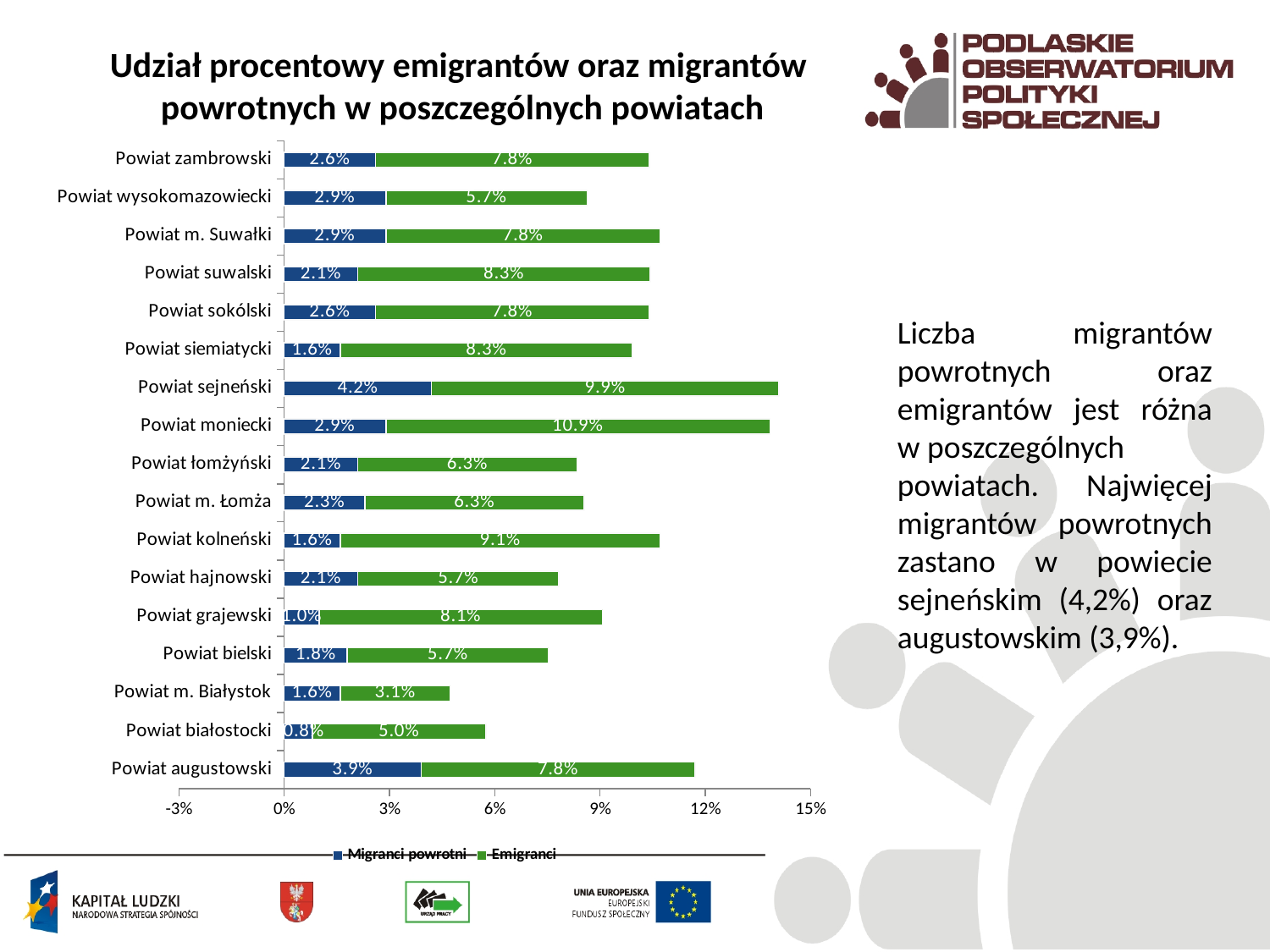
What is the total of the stacked bar for Powiat sejneński? 14.1% How many series does the legend list? 2 Which powiat has the highest Migranci powrotni value? Powiat sejneński What is the Emigranci value for Powiat moniecki? 10.9% What is the Migranci powrotni value for Powiat sejneński? 4.2% Which powiat has the highest Emigranci value? Powiat moniecki What is the Migranci powrotni value for Powiat białostocki? 0.8% What type of chart is shown on the slide? bar chart Which is larger, the Emigranci value for Powiat kolneński or for Powiat grajewski? Powiat kolneński What is the difference between the Migranci powrotni values for Powiat sejneński and Powiat augustowski? 0.3% How many powiats (categories) are shown in the chart? 17 Which powiat has the lowest Emigranci value? Powiat m. Białystok